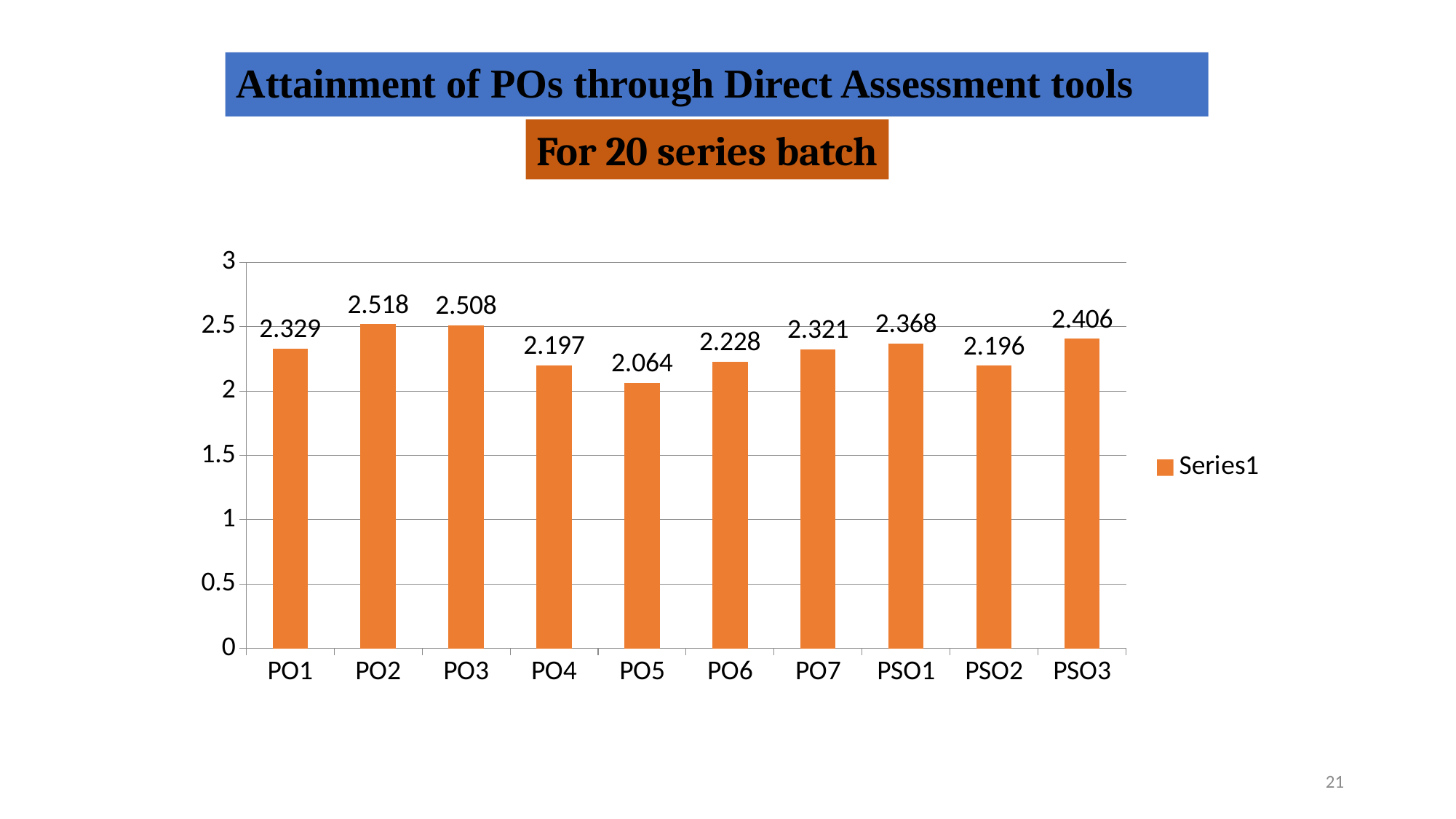
Is the value for PO3 greater or less than 2.5? greater What is the value for PO5? 2.064 Which category has the lowest value? PO5 Which category has the highest value? PO2 Which is larger, the value for PSO1 or the value for PO6? PSO1 What is the difference between the values for PO2 and PO5? 0.454 What is the legend entry for the series? Series1 How many categories are shown on the x axis? 10 What is the value for PO1? 2.329 How many series does the legend list? 1 What kind of chart is shown on the slide? bar chart What is the value for PSO3? 2.406